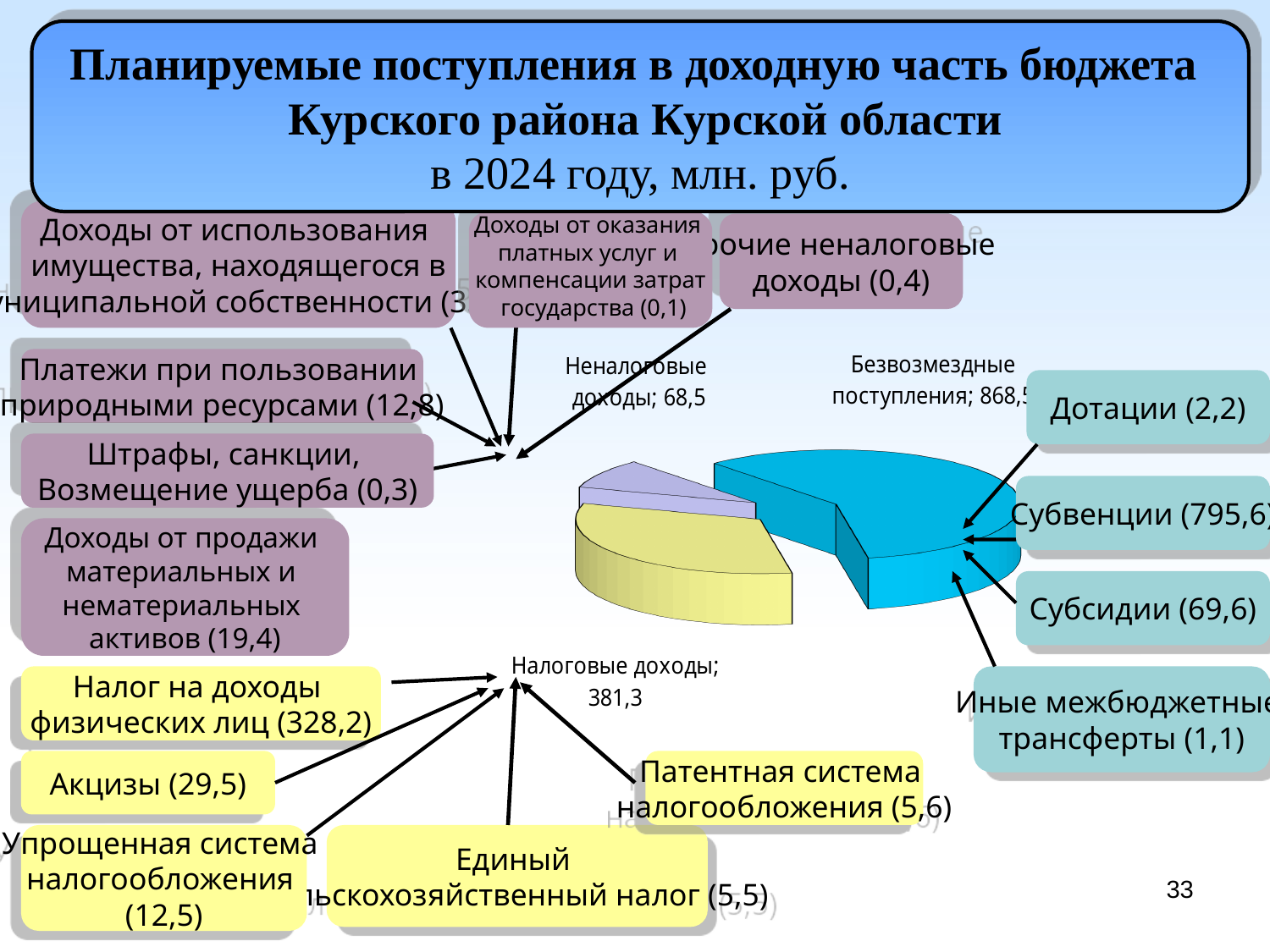
In what units are the values on the slide expressed, according to the title? млн. руб. Which slice of the pie chart is the smallest? Неналоговые доходы What colour is the Налоговые доходы slice of the pie chart? yellow How many slices does the pie chart have? 3 What is the difference between the values for Налоговые доходы and Неналоговые доходы in the pie chart? 312,8 Which is larger in the pie chart, Налоговые доходы or Неналоговые доходы? Налоговые доходы Which slice of the pie chart is the largest? Безвозмездные поступления Which is larger in the pie chart, Безвозмездные поступления or Налоговые доходы? Безвозмездные поступления What is the value shown for Налоговые доходы in the pie chart? 381,3 What is the value shown for Неналоговые доходы in the pie chart? 68,5 What kind of chart is shown on the slide? pie chart